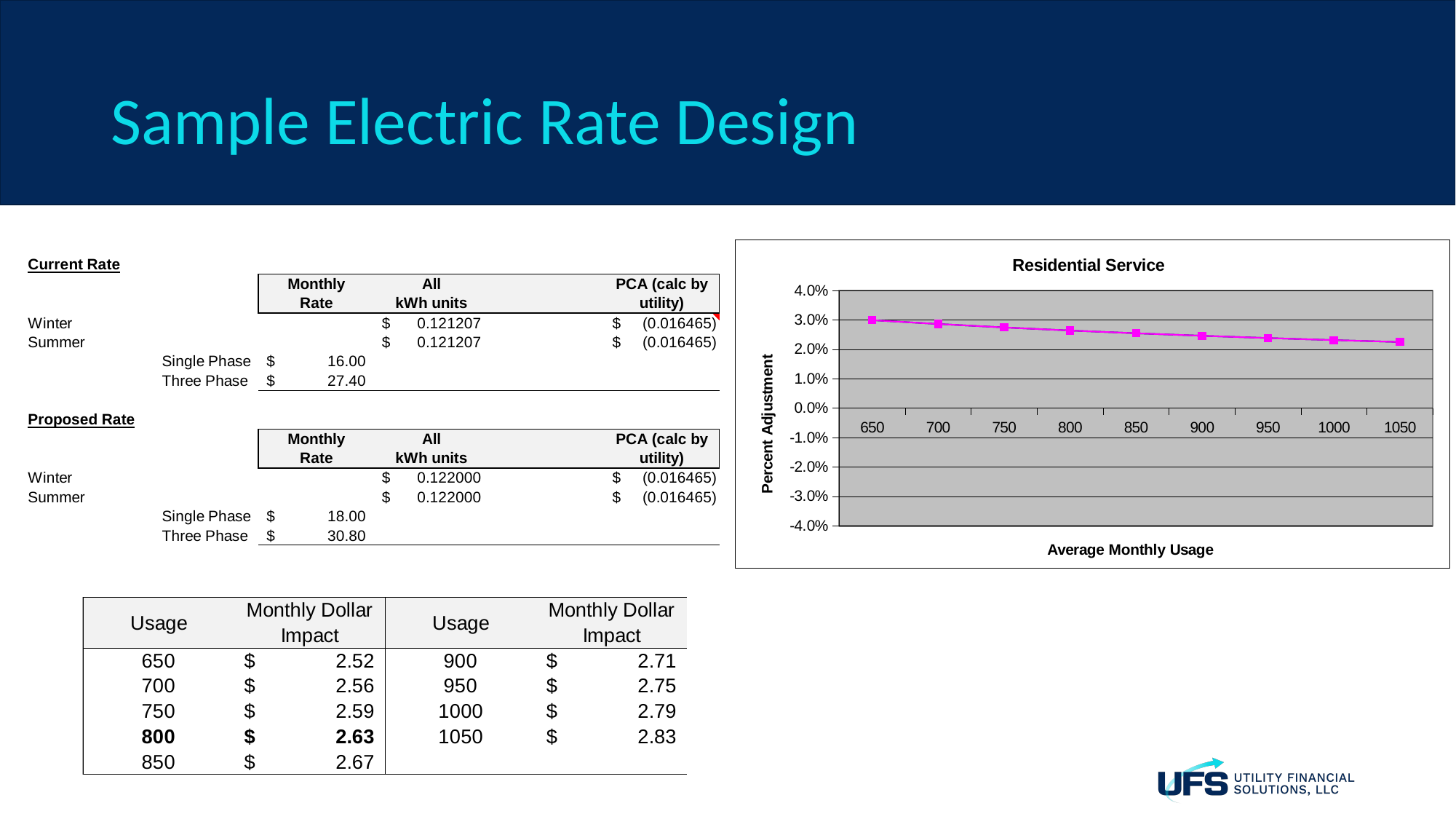
Do the values on the Residential Service chart rise or fall as average monthly usage increases? fall What kind of chart is the Residential Service chart? line chart On the Residential Service chart, which has the larger percent adjustment, 700 or 1000? 700 How many data points are plotted on the Residential Service chart? 9 On the Residential Service chart, is the percent adjustment at 1050 greater or less than 2.0%? greater On the Residential Service chart, is the percent adjustment at 900 greater or less than 0.0%? greater On the Residential Service chart, is the percent adjustment at 750 greater or less than 2.0%? greater Which average monthly usage has the lowest percent adjustment on the Residential Service chart? 1050 What is the label of the x axis of the Residential Service chart? Average Monthly Usage What is the title of the chart on the slide? Residential Service Which average monthly usage has the highest percent adjustment on the Residential Service chart? 650